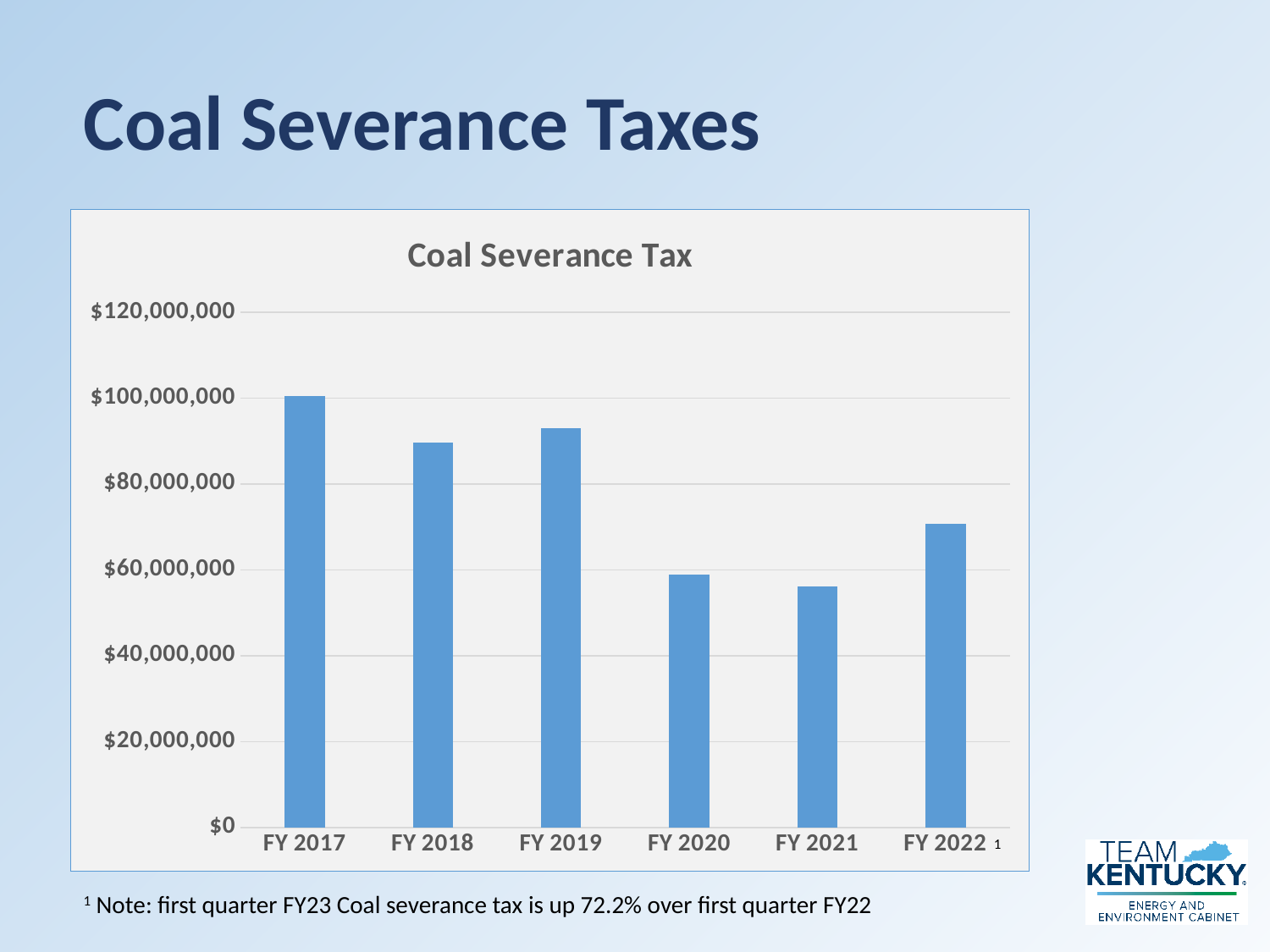
Is the value for FY 2021 greater or less than $60,000,000? less Which fiscal year has the lowest coal severance tax? FY 2021 Do the values rise or fall from FY 2019 to FY 2021? fall Is the value for FY 2022 greater or less than $80,000,000? less Is the value for FY 2018 greater or less than $80,000,000? greater What kind of chart is shown on the slide? bar chart What is the title of the chart? Coal Severance Tax Which is larger, the value for FY 2022 or the value for FY 2020? FY 2022 Which is larger, the value for FY 2019 or the value for FY 2018? FY 2019 How many fiscal years are plotted in the chart? 6 Which fiscal year has the highest coal severance tax? FY 2017